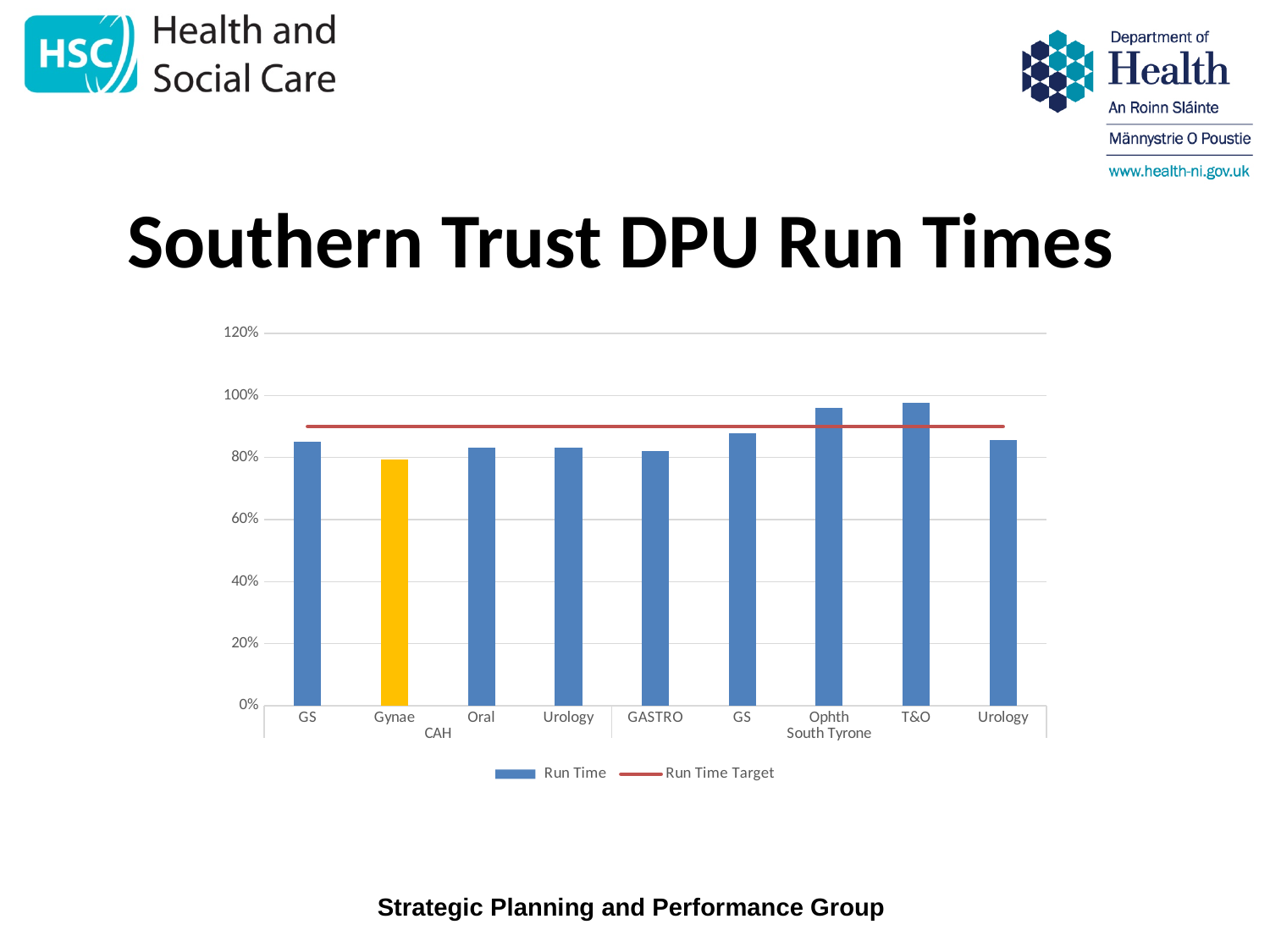
How many series does the legend list? 2 How many bars are plotted in the chart? 9 Is the run time for GASTRO (South Tyrone) greater or less than 90%? less What kind of chart is shown on the slide? bar chart Which category has the highest run time? T&O (South Tyrone) What is the title of the chart on the slide? Southern Trust DPU Run Times Which category has the lowest run time? Gynae (CAH) Which bar is coloured yellow instead of blue? Gynae (CAH) Which has the larger run time, GS (South Tyrone) or Gynae (CAH)? GS (South Tyrone) Which has the larger run time, Ophth (South Tyrone) or Oral (CAH)? Ophth (South Tyrone) Is the run time for T&O (South Tyrone) greater or less than 90%? greater